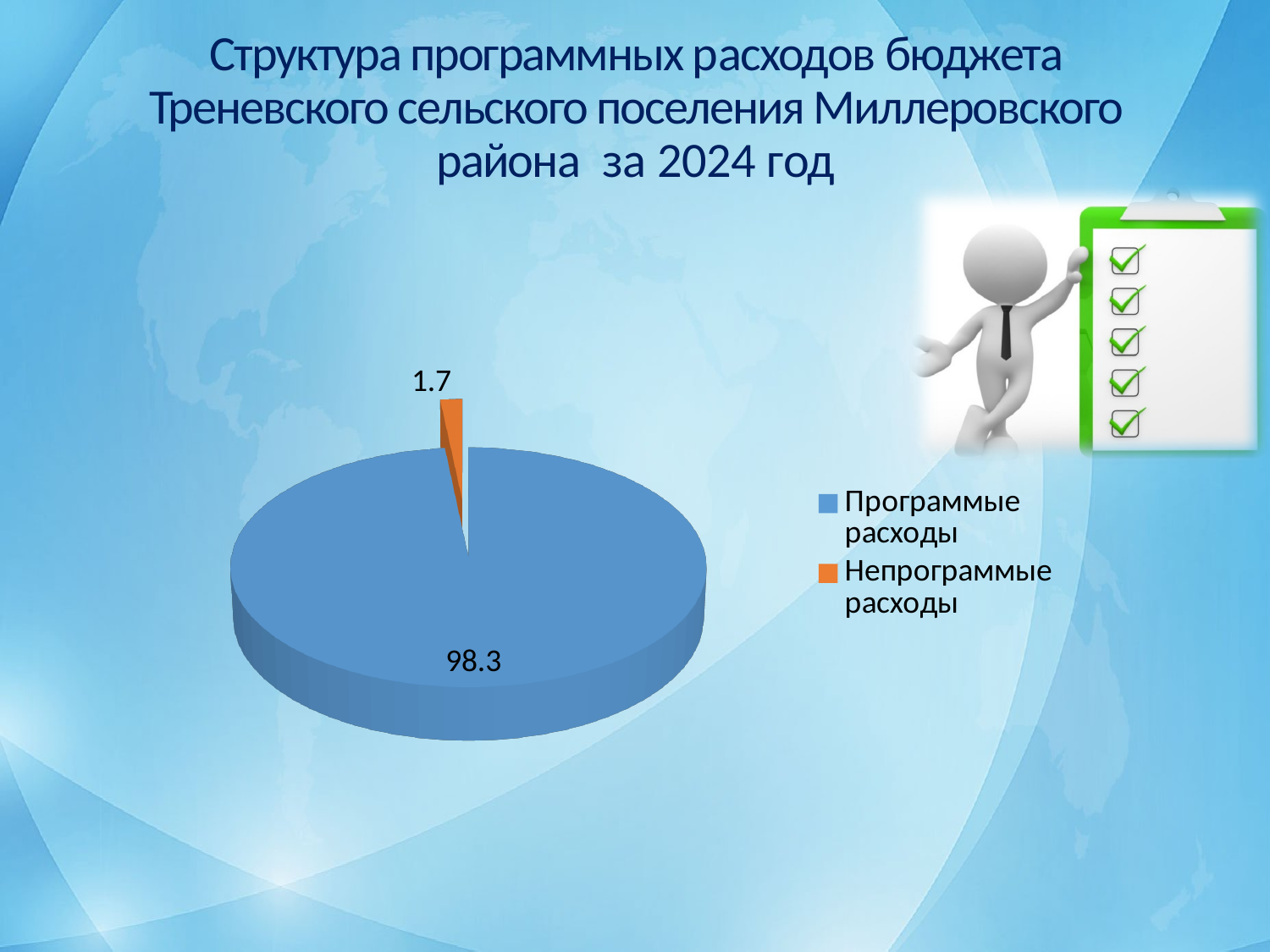
What is the total of the two values shown on the pie chart? 100 Which category has the largest slice of the pie? Программые расходы What kind of chart is shown on the slide? pie chart How many slices does the pie chart have? 2 What colour is the slice for Непрограммые расходы? orange What is the value for Непрограммые расходы? 1.7 How many entries does the legend list? 2 What is the difference between the values for Программые расходы and Непрограммые расходы? 96.6 What colour is the slice for Программые расходы? blue Which category has the smallest slice of the pie? Непрограммые расходы Which is larger: Программые расходы or Непрограммые расходы? Программые расходы What is the value for Программые расходы? 98.3